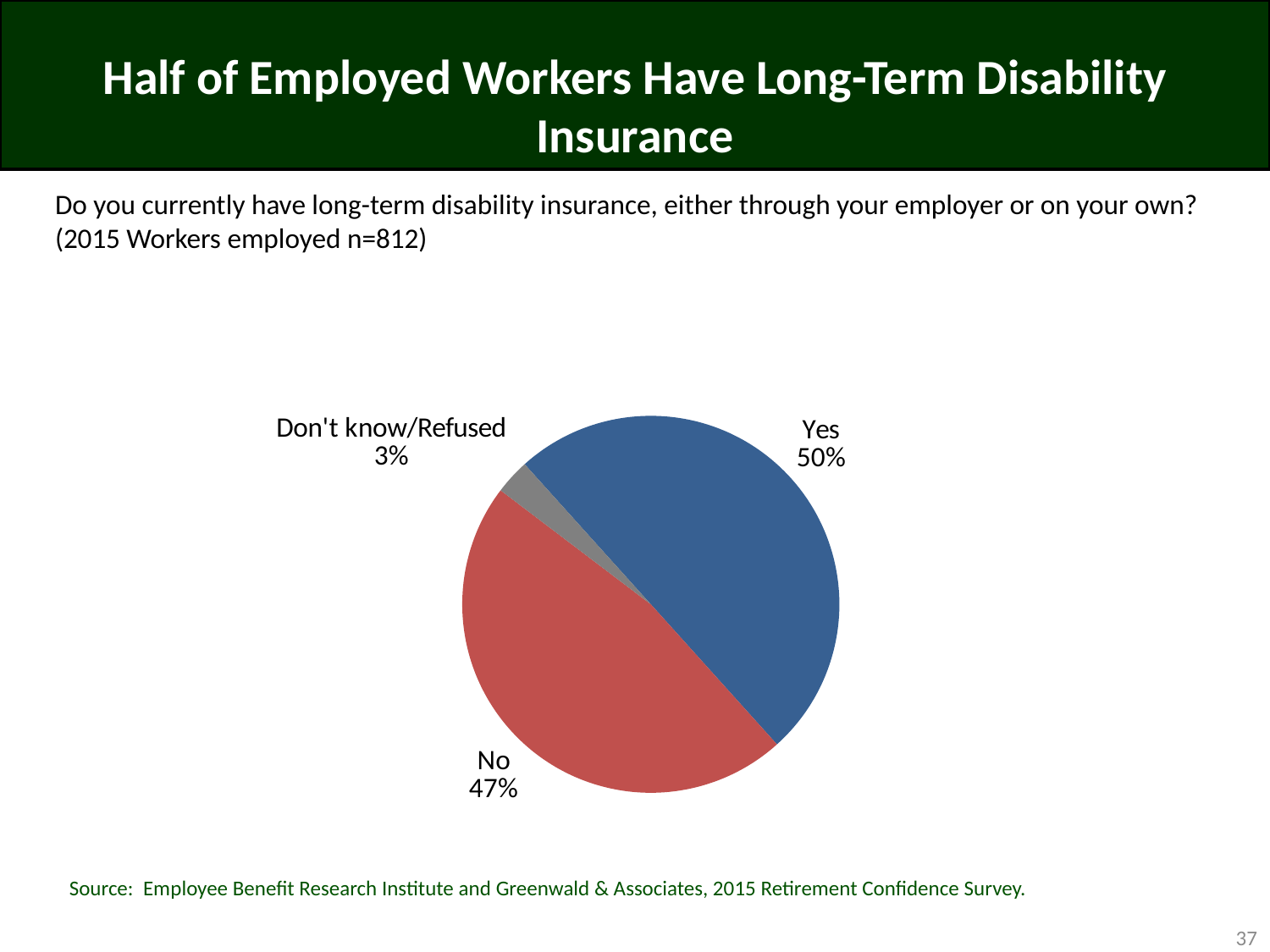
What is the difference in percentage points between the "Yes" and "No" slices? 3 What percentage of respondents answered "Don't know/Refused"? 3% What kind of chart is shown on the slide? Pie chart What is the difference in percentage points between the "No" and "Don't know/Refused" slices? 44 What colour is the "No" slice of the pie? Red What is the sample size (n) stated for the 2015 employed workers surveyed? 812 What percentage of employed workers answered "No"? 47% Which slice is larger, "Yes" or "No"? Yes Which response has the smallest share of the pie? Don't know/Refused Which response has the largest share of the pie? Yes What percentage of employed workers answered "Yes" to having long-term disability insurance? 50% How many slices does the pie chart have? 3